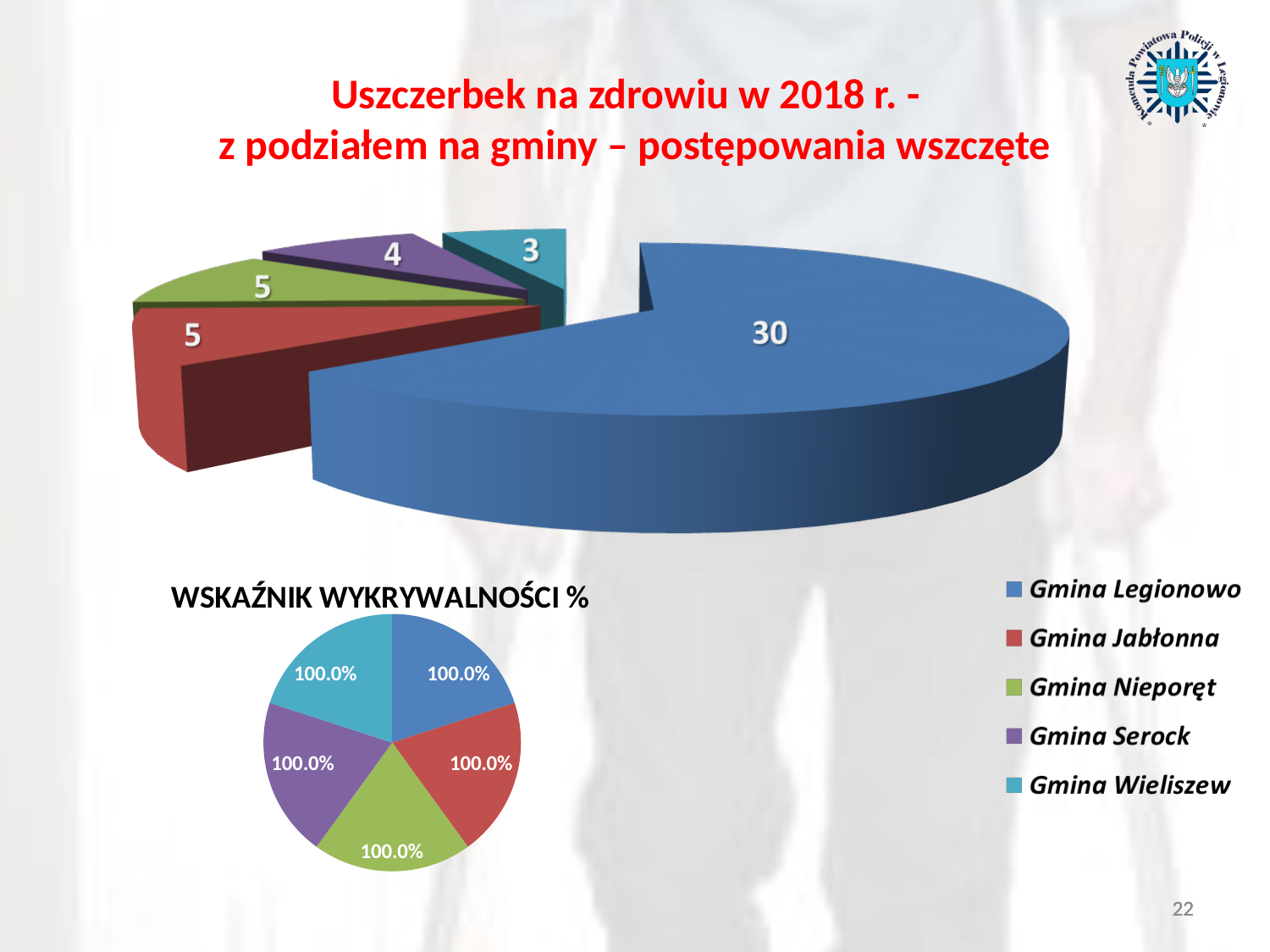
In the chart titled WSKAŹNIK WYKRYWALNOŚCI %, what is the value shown for Gmina Nieporęt? 100.0% In the large pie chart at the top, what is the value for Gmina Jabłonna? 5 In the large pie chart at the top, what is the value for Gmina Legionowo? 30 In the large pie chart at the top, which gmina has the lowest value? Gmina Wieliszew How many entries does the legend on the slide list? 5 In the large pie chart at the top, what is the value for Gmina Wieliszew? 3 How many slices does the large pie chart at the top have? 5 In the large pie chart at the top, what is the value for Gmina Serock? 4 In the large pie chart at the top, which gmina has the highest value? Gmina Legionowo In the large pie chart at the top, what is the difference between the values for Gmina Legionowo and Gmina Serock? 26 In the large pie chart at the top, which is larger: the value for Gmina Serock or for Gmina Wieliszew? Gmina Serock What kind of chart is the chart titled WSKAŹNIK WYKRYWALNOŚCI %? pie chart